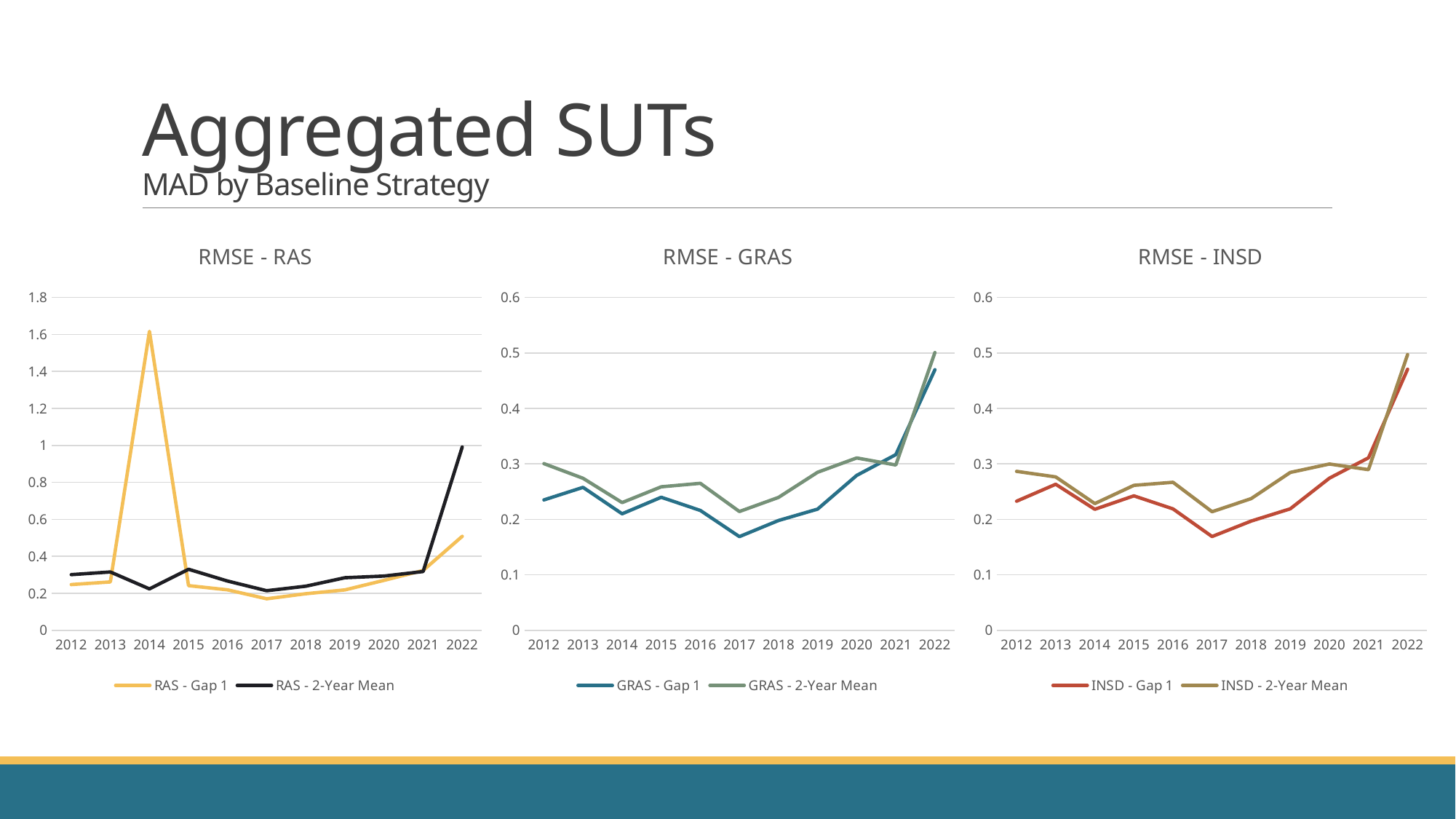
What are the two legend entries of the RMSE - INSD chart? INSD - Gap 1 and INSD - 2-Year Mean In the RMSE - RAS chart, is the value of RAS - Gap 1 in 2014 greater or less than 1.4? greater In the RMSE - GRAS chart, in which year is GRAS - Gap 1 at its lowest? 2017 In the RMSE - RAS chart, in which year does RAS - Gap 1 reach its highest value? 2014 In the RMSE - GRAS chart, which series has the larger value in 2017, GRAS - Gap 1 or GRAS - 2-Year Mean? GRAS - 2-Year Mean In the RMSE - GRAS chart, is the value of GRAS - Gap 1 in 2017 greater or less than 0.2? less How many years are plotted along the x axis of the RMSE - INSD chart? 11 In the RMSE - INSD chart, is the value of INSD - Gap 1 in 2022 greater or less than 0.4? greater How many series does the legend of the RMSE - GRAS chart list? 2 How many charts are shown on the slide? 3 What kind of chart is the RMSE - RAS chart? line chart